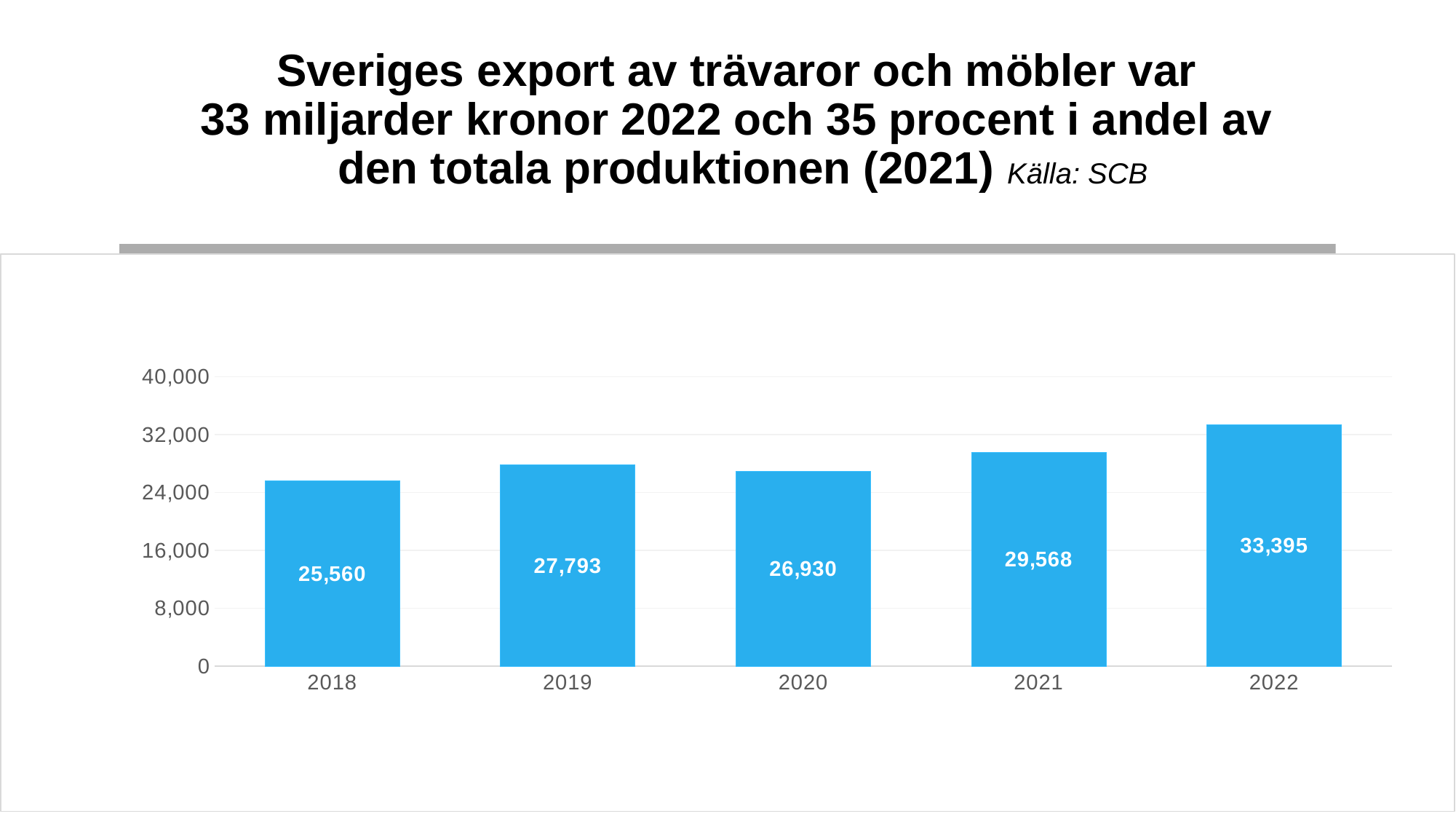
How many years are shown on the x axis? 5 What source is cited in the slide title? SCB What is the value for 2018? 25,560 Is the value for 2022 greater or less than 32,000? greater Which year has the lowest value? 2018 What is the difference between the values for 2019 and 2020? 863 What is the difference between the values for 2022 and 2021? 3,827 Which year has the highest value? 2022 Which is larger, the value for 2019 or the value for 2020? 2019 What is the value for 2022? 33,395 What is the value for 2020? 26,930 What kind of chart is shown on the slide? bar chart